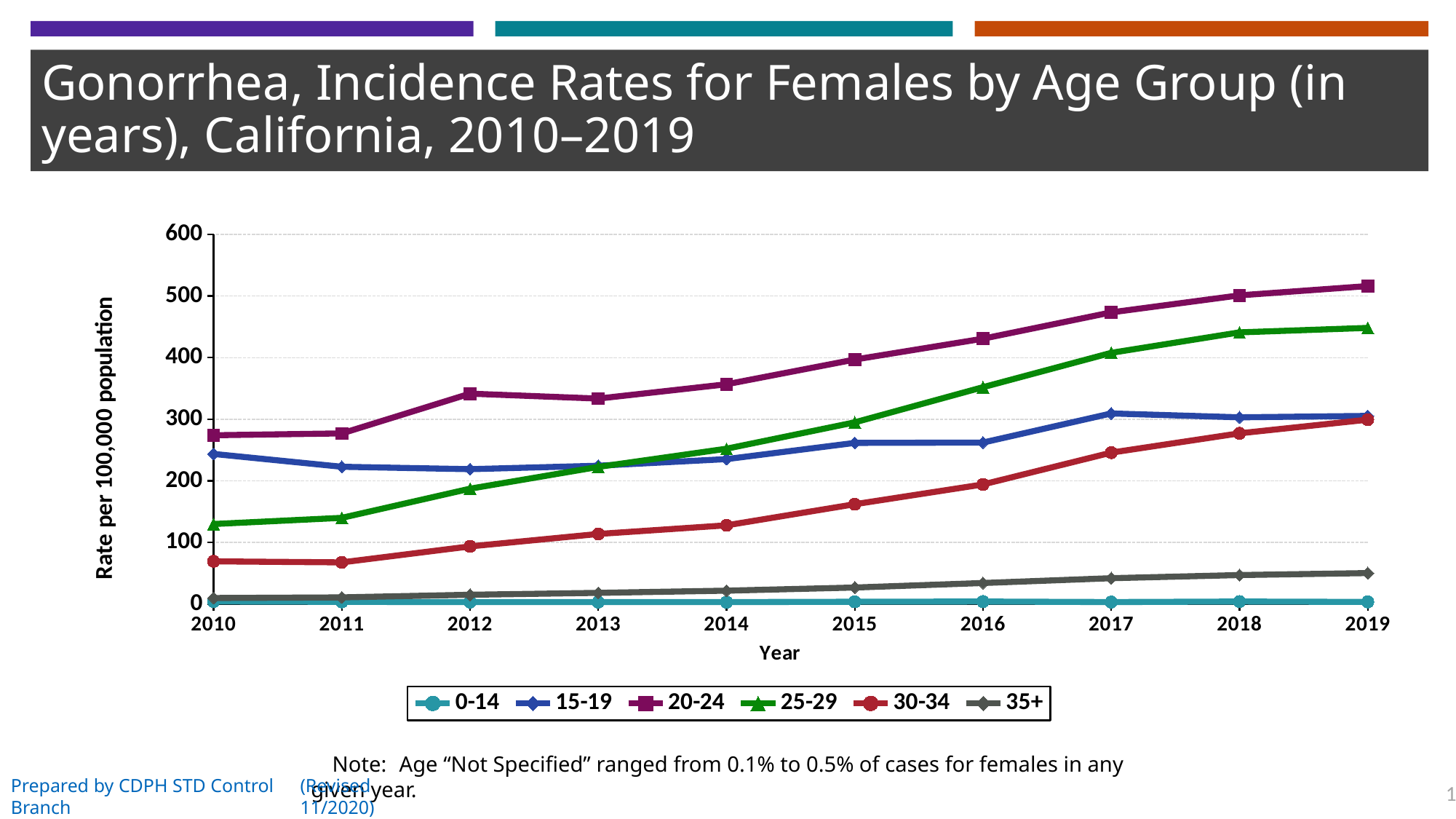
How many series does the legend list? 6 Does the rate for the 30-34 age group rise or fall from 2010 to 2019? rise Is the value for the 35+ age group in 2019 greater or less than 100? less Which age group has the lowest rate in 2019? 0-14 Is the value for the 30-34 age group in 2010 greater or less than 100? less In 2010, which is larger: the rate for the 15-19 age group or the 25-29 age group? 15-19 In 2019, which is larger: the rate for the 25-29 age group or the 15-19 age group? 25-29 What kind of chart is shown on the slide? line chart How many years are plotted along the x axis? 10 Is the value for the 20-24 age group in 2019 greater or less than 500? greater Which age group has the highest rate in 2019? 20-24